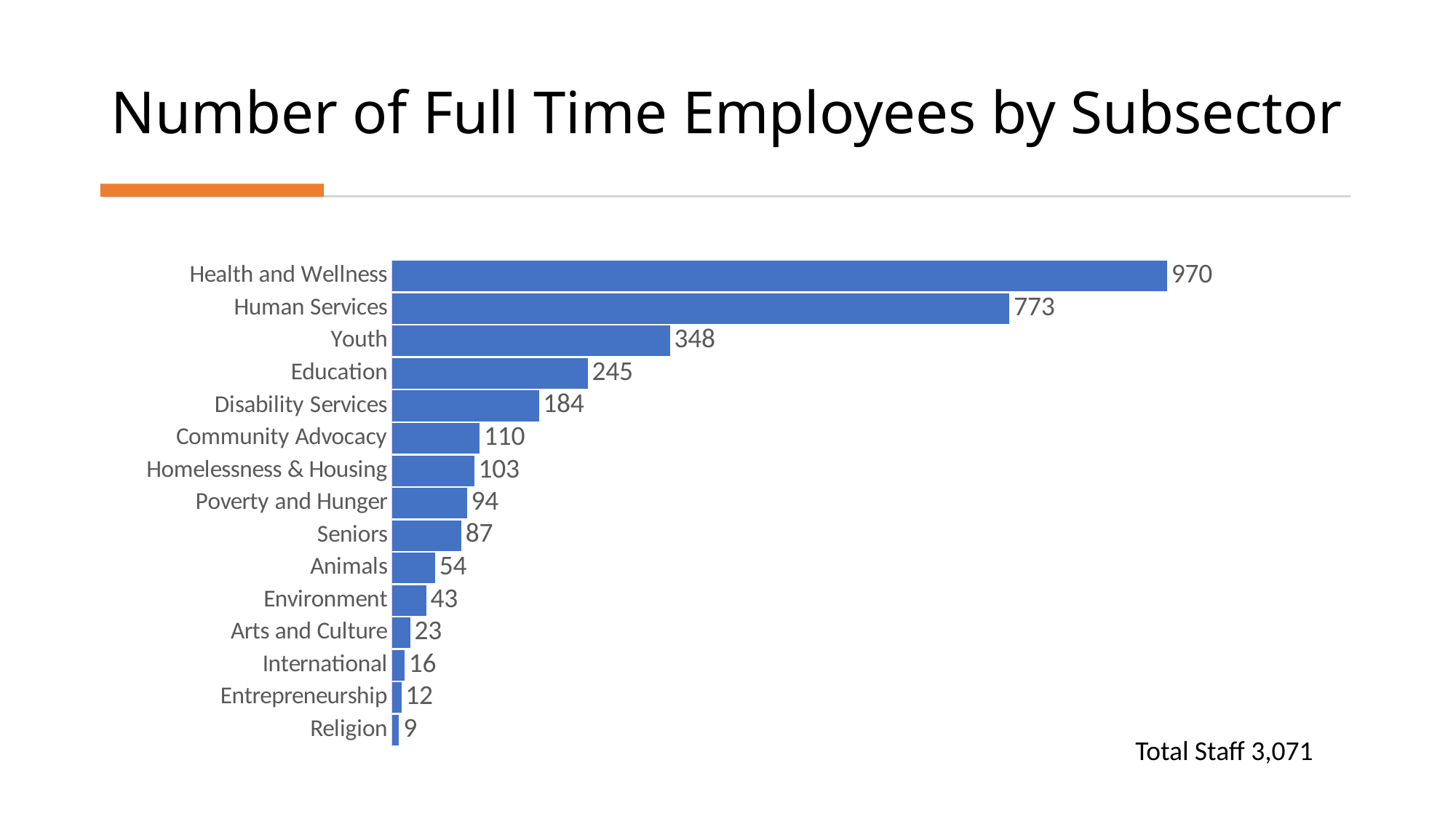
Which subsector has the highest number of full time employees? Health and Wellness What is the difference in full time employees between Health and Wellness and Human Services? 197 Which has more full time employees, Community Advocacy or Homelessness & Housing? Community Advocacy What is the difference in full time employees between Youth and Education? 103 How many subsectors are shown in the chart? 15 Which subsector has the lowest number of full time employees? Religion What is the number of full time employees for Health and Wellness? 970 What is the number of full time employees for Arts and Culture? 23 What kind of chart is shown on the slide? Bar chart Which has more full time employees, Animals or Environment? Animals What is the number of full time employees for Disability Services? 184 What total staff figure is shown on the slide? 3,071